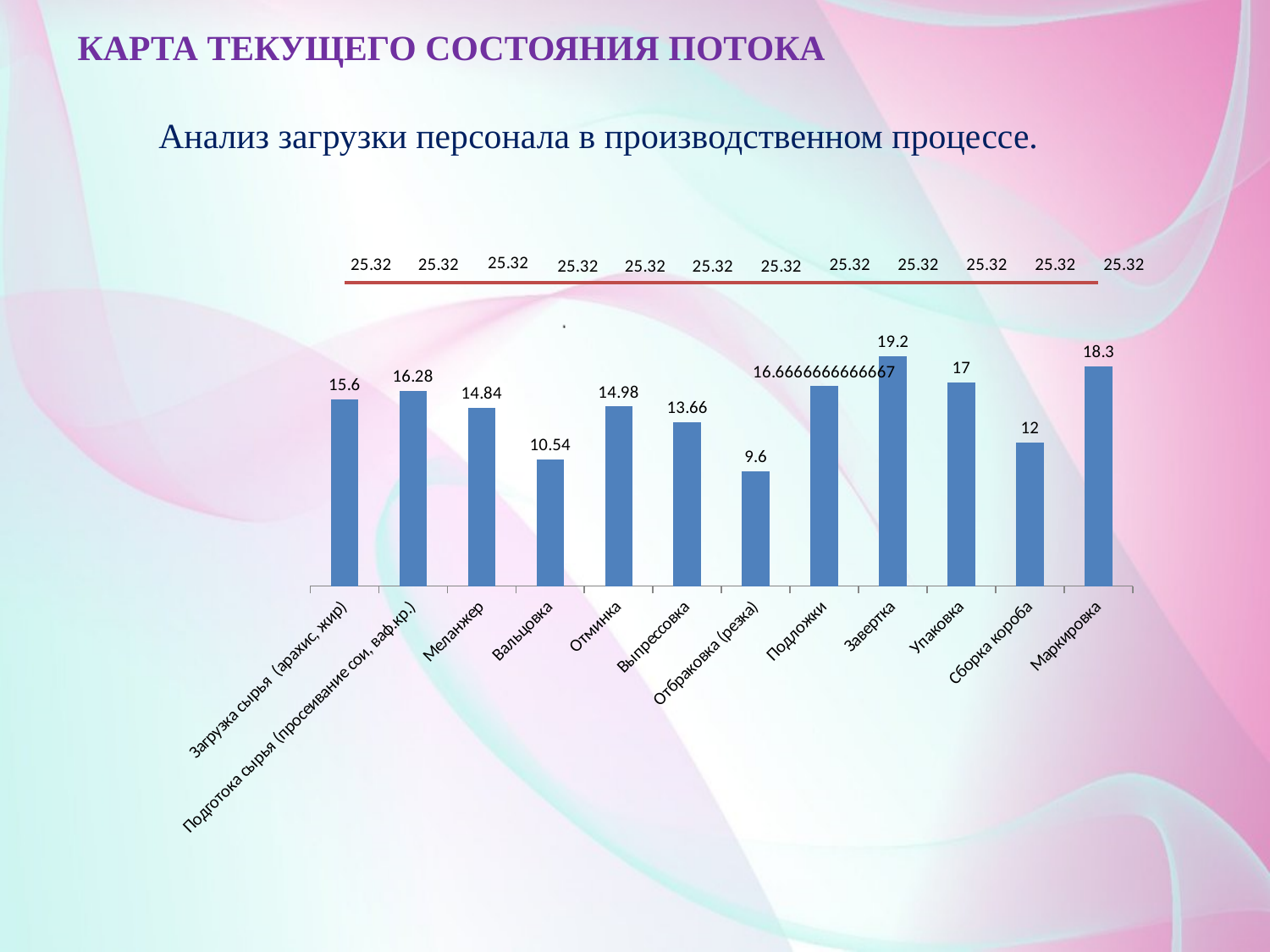
What is the difference between the values for Упаковка and Сборка короба? 5 What constant value does the red line above the bars show? 25.32 Which is larger, the value for Меланжер or the value for Отминка? Отминка How many categories are shown on the x axis of the chart? 12 What kind of chart is shown on the slide? Combination bar and line chart What is the difference between the values for Завертка and Отбраковка (резка)? 9.6 Which category has the highest bar? Завертка What is the value of the bar for Упаковка? 17 Which category has the lowest bar? Отбраковка (резка) What is the value of the bar for Маркировка? 18.3 What is the value of the bar for Вальцовка? 10.54 What is the value of the bar for Завертка? 19.2